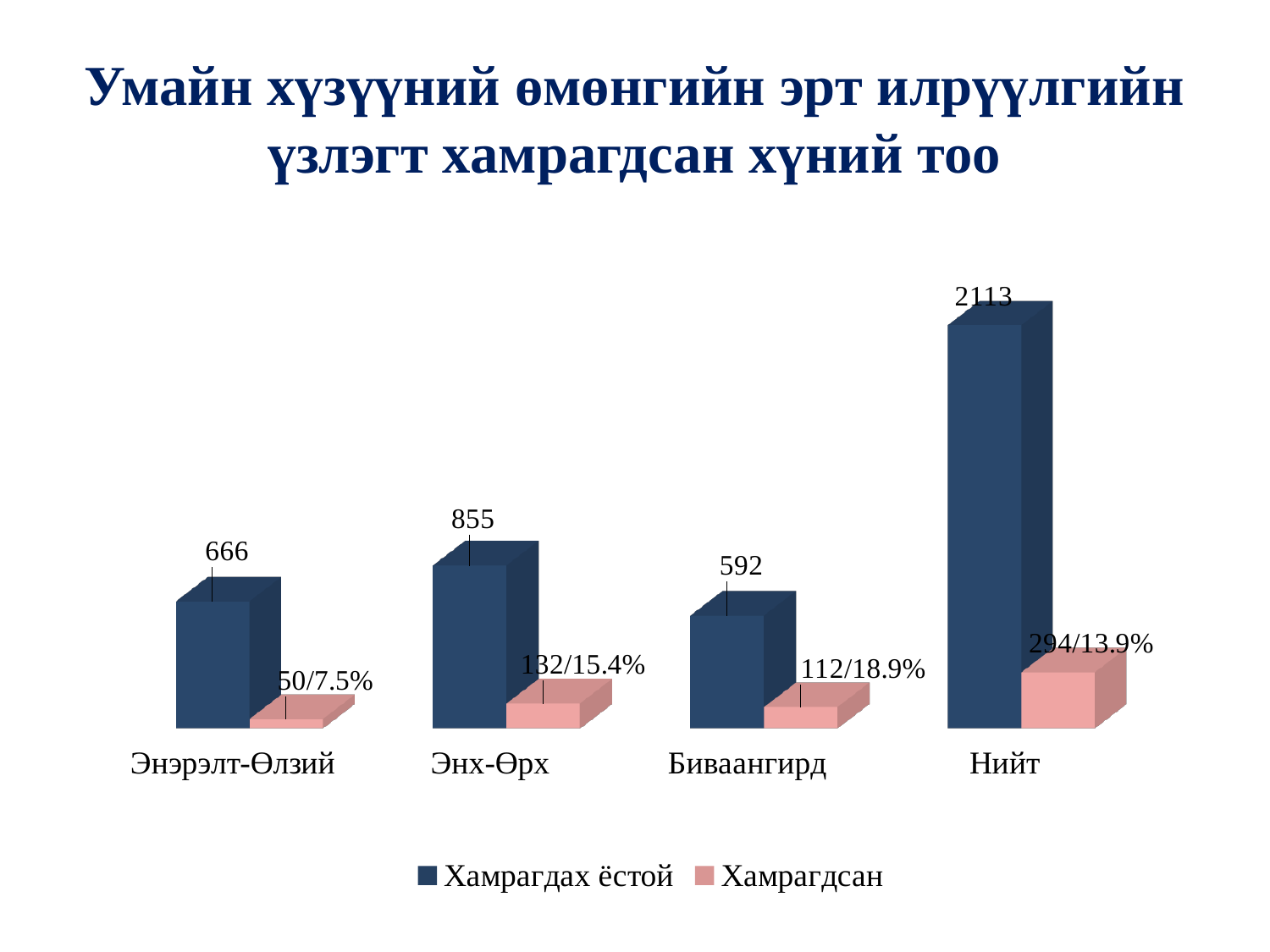
What is the data label for Хамрагдсан for Нийт? 294/13.9% Which category has the highest Хамрагдах ёстой value? Нийт What is the value of Хамрагдах ёстой for Энх-Өрх? 855 What kind of chart is shown on the slide? Bar chart What is the difference between the Хамрагдах ёстой values for Энх-Өрх and Энэрэлт-Өлзий? 189 How many categories are shown on the x axis? 4 What is the value of Хамрагдах ёстой for Нийт? 2113 Which is larger, the Хамрагдах ёстой value for Энэрэлт-Өлзий or for Биваангирд? Энэрэлт-Өлзий Which category has the lowest Хамрагдах ёстой value? Биваангирд What is the data label for Хамрагдсан for Биваангирд? 112/18.9% What are the two series named in the legend? Хамрагдах ёстой and Хамрагдсан How many series does the legend list? 2